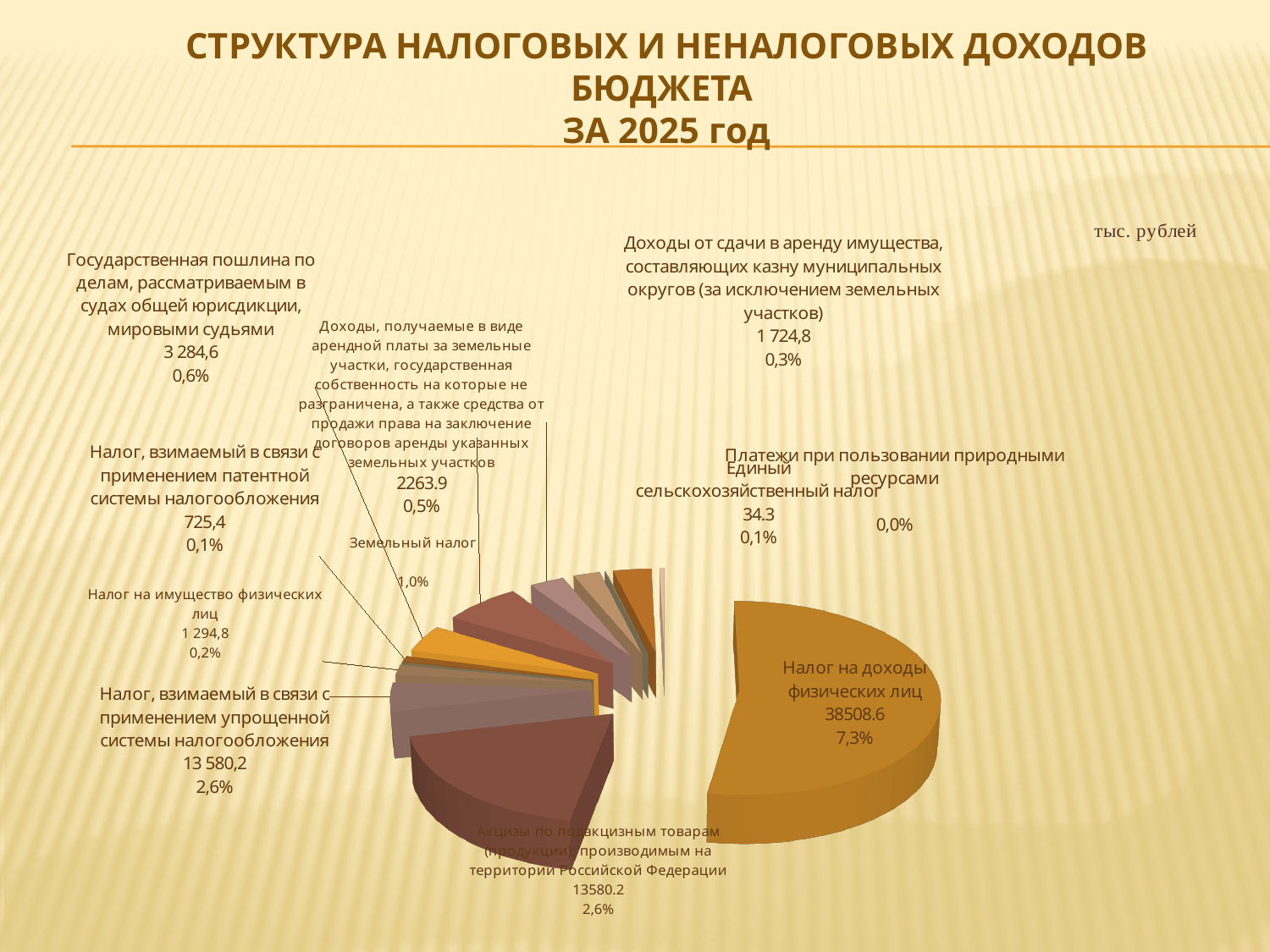
What is the value for Налог на доходы физических лиц? 38508.6 Which is larger: Налог, взимаемый в связи с применением патентной системы налогообложения or Налог на имущество физических лиц? Налог на имущество физических лиц What is the value for Государственная пошлина по делам, рассматриваемым в судах общей юрисдикции, мировыми судьями? 3 284,6 What is the value for Налог на имущество физических лиц? 1 294,8 In what units are the values on the chart given, according to the note at the top right? тыс. рублей What is the value for Единый сельскохозяйственный налог? 34.3 What share of the pie is labelled for Налог на доходы физических лиц? 7,3% What share of the pie is labelled for Земельный налог? 1,0% What is the value for Налог, взимаемый в связи с применением упрощенной системы налогообложения? 13 580,2 What is the difference between the values for Налог на доходы физических лиц (38508.6) and Акцизы по подакцизным товарам (13580.2)? 24928.4 Which category has the largest value in the pie chart? Налог на доходы физических лиц What kind of chart is shown on the slide? pie chart